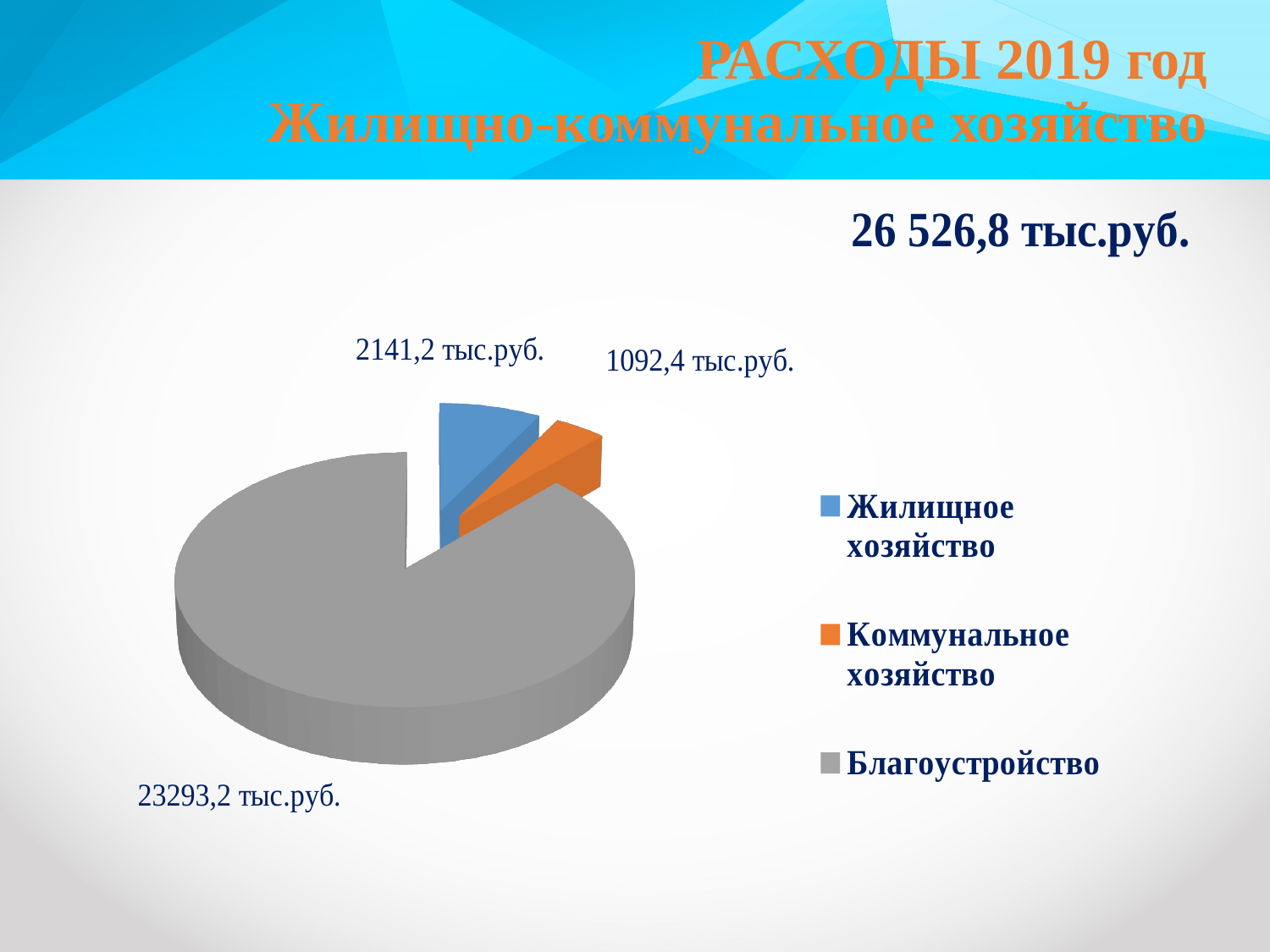
What type of chart is shown on the slide? Pie chart What is the difference between Благоустройство and Жилищное хозяйство? 21152,0 тыс.руб. What colour is the slice for Коммунальное хозяйство? Orange What total amount is shown on the slide for the expenses? 26 526,8 тыс.руб. What is the value for Коммунальное хозяйство? 1092,4 тыс.руб. Which category has the smallest slice of the pie? Коммунальное хозяйство How many slices does the pie chart have? 3 What is the value for Жилищное хозяйство? 2141,2 тыс.руб. What is the value for Благоустройство? 23293,2 тыс.руб. What is the difference between Жилищное хозяйство and Коммунальное хозяйство? 1048,8 тыс.руб. Which is larger, Жилищное хозяйство or Коммунальное хозяйство? Жилищное хозяйство Which category has the largest slice of the pie? Благоустройство